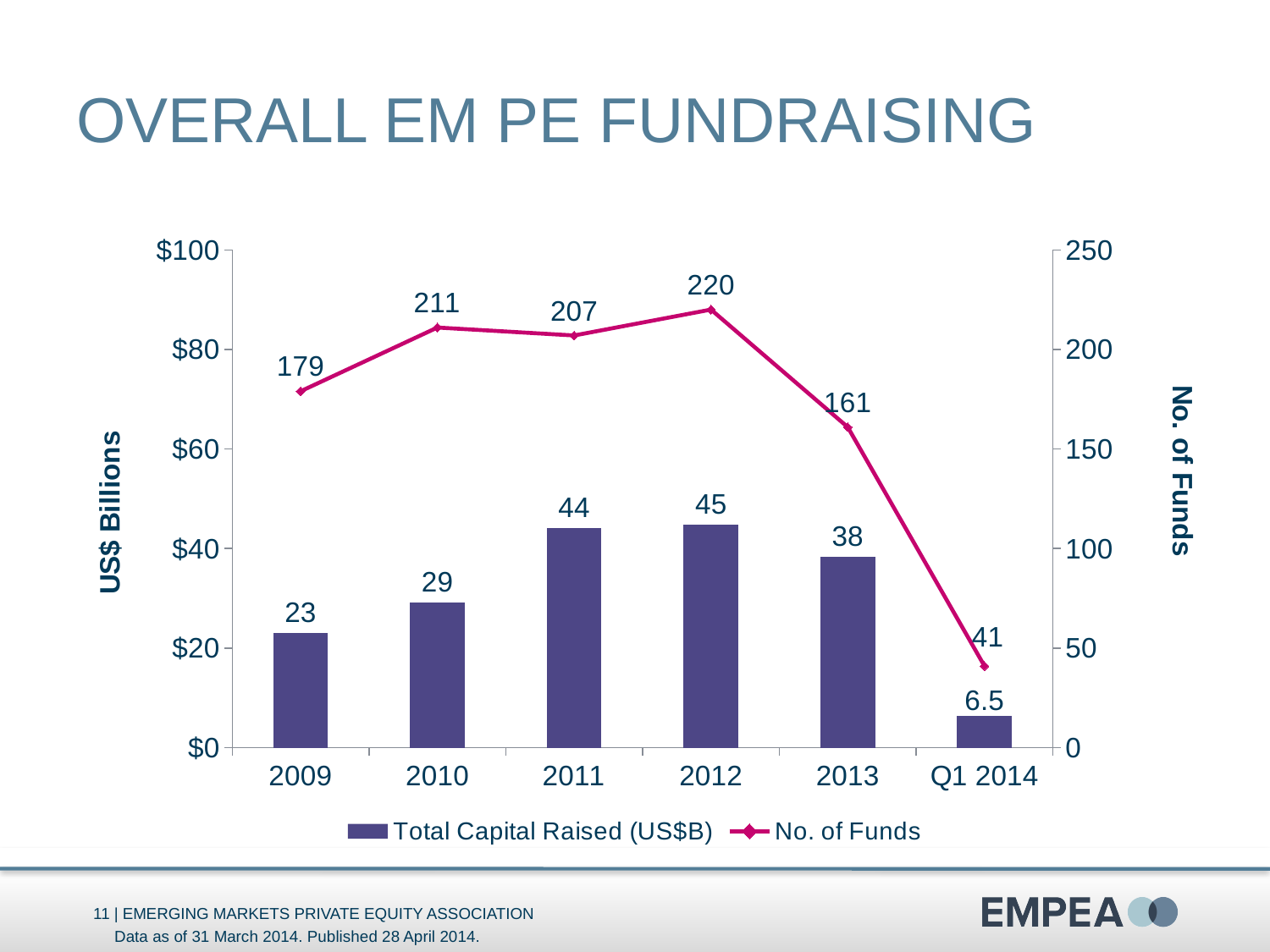
Which year had more Total Capital Raised (US$B), 2010 or 2013? 2013 What is the difference in No. of Funds between 2012 and 2013? 59 What was the Total Capital Raised (US$B) in Q1 2014? 6.5 Which period had the lowest No. of Funds? Q1 2014 What was the Total Capital Raised (US$B) in 2011? 44 How many periods are shown on the x axis? 6 Which year had the highest Total Capital Raised (US$B)? 2012 Did the No. of Funds rise or fall from 2012 to 2013? Fall What was the No. of Funds in 2012? 220 What kind of chart is used for the Total Capital Raised (US$B) series? Bar chart How many series does the legend list? 2 What is the label of the right-hand vertical axis? No. of Funds